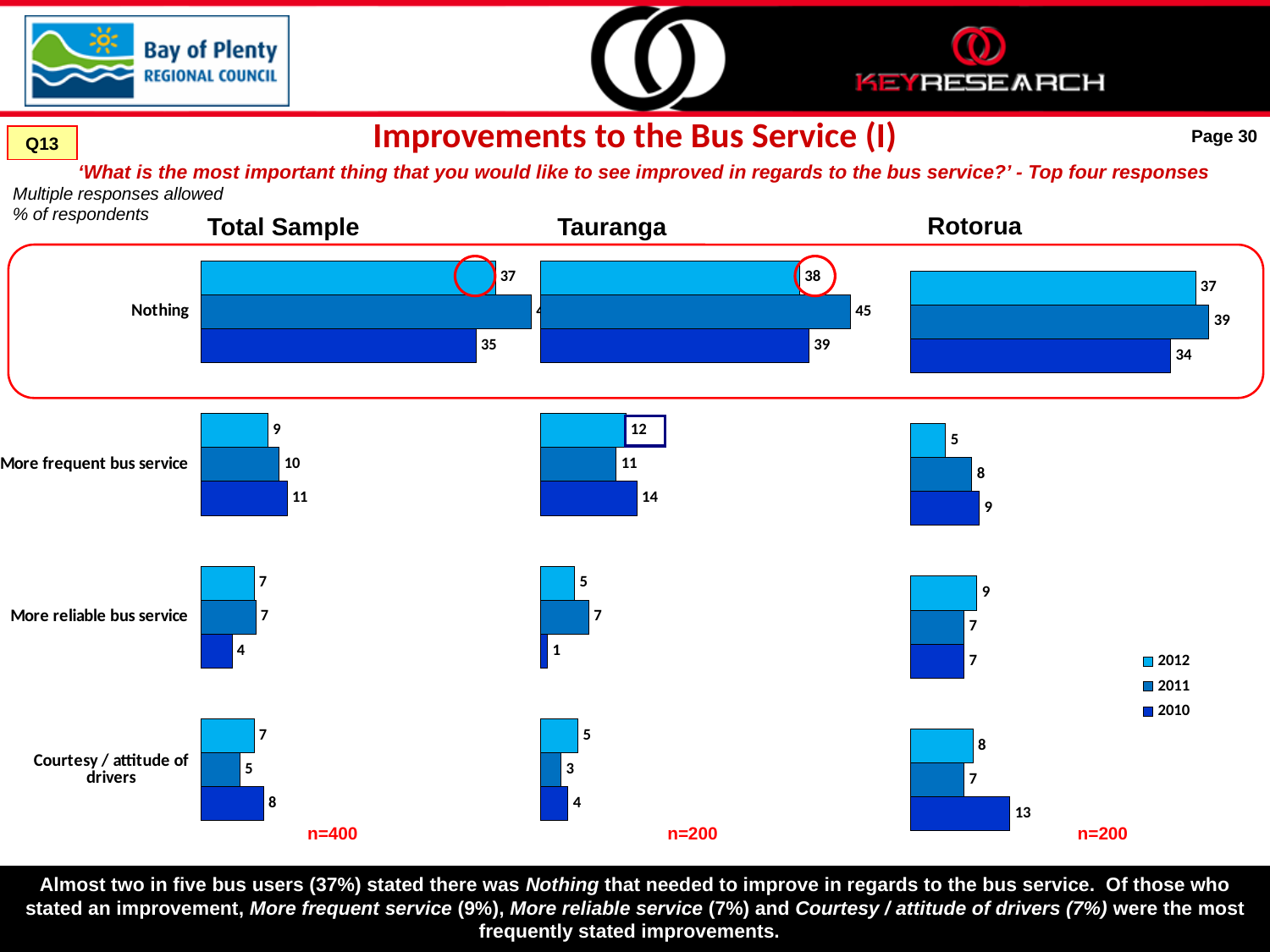
In the Tauranga chart, what is the difference between the 2010 and 2012 values for More frequent bus service? 2 In the Tauranga chart, what is the 2011 value for Nothing? 45 How many series does the legend list? 3 In the Rotorua chart, is the 2012 value for More frequent bus service larger or smaller than the 2010 value? smaller What kind of chart is used for the Tauranga data? bar chart In the Total Sample chart, what is the 2012 value for Nothing? 37 In the Rotorua chart, what is the 2010 value for Courtesy / attitude of drivers? 13 How many categories are shown in the Total Sample chart? 4 In the Rotorua chart, which year has the highest value for Nothing? 2011 In the Tauranga chart, which year has the lowest value for Courtesy / attitude of drivers? 2011 In the Tauranga chart, what is the 2010 value for More reliable bus service? 1 What is the sample size (n) shown under the Total Sample chart? n=400